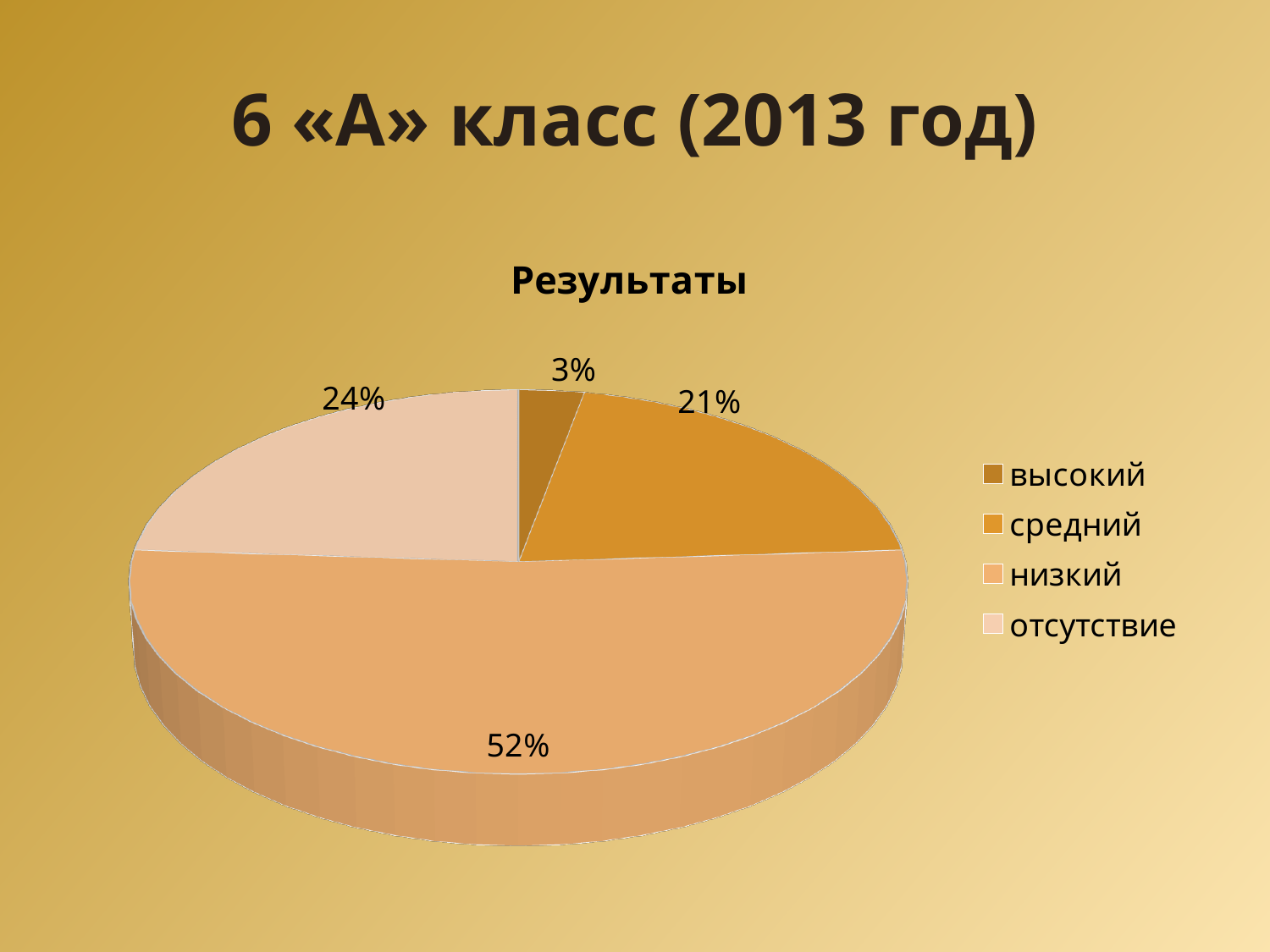
Which category has the smallest slice of the pie? высокий What share of the pie does the "средний" slice represent? 21% What share of the pie does the "высокий" slice represent? 3% What is the difference in percentage points between the "низкий" and "отсутствие" slices? 28 What share of the pie does the "низкий" slice represent? 52% Which category has the largest slice of the pie? низкий What kind of chart is shown on the slide? pie chart Which slice is larger, "средний" or "отсутствие"? отсутствие How many entries does the legend list? 4 How many slices does the pie chart have? 4 What is the chart's title? Результаты